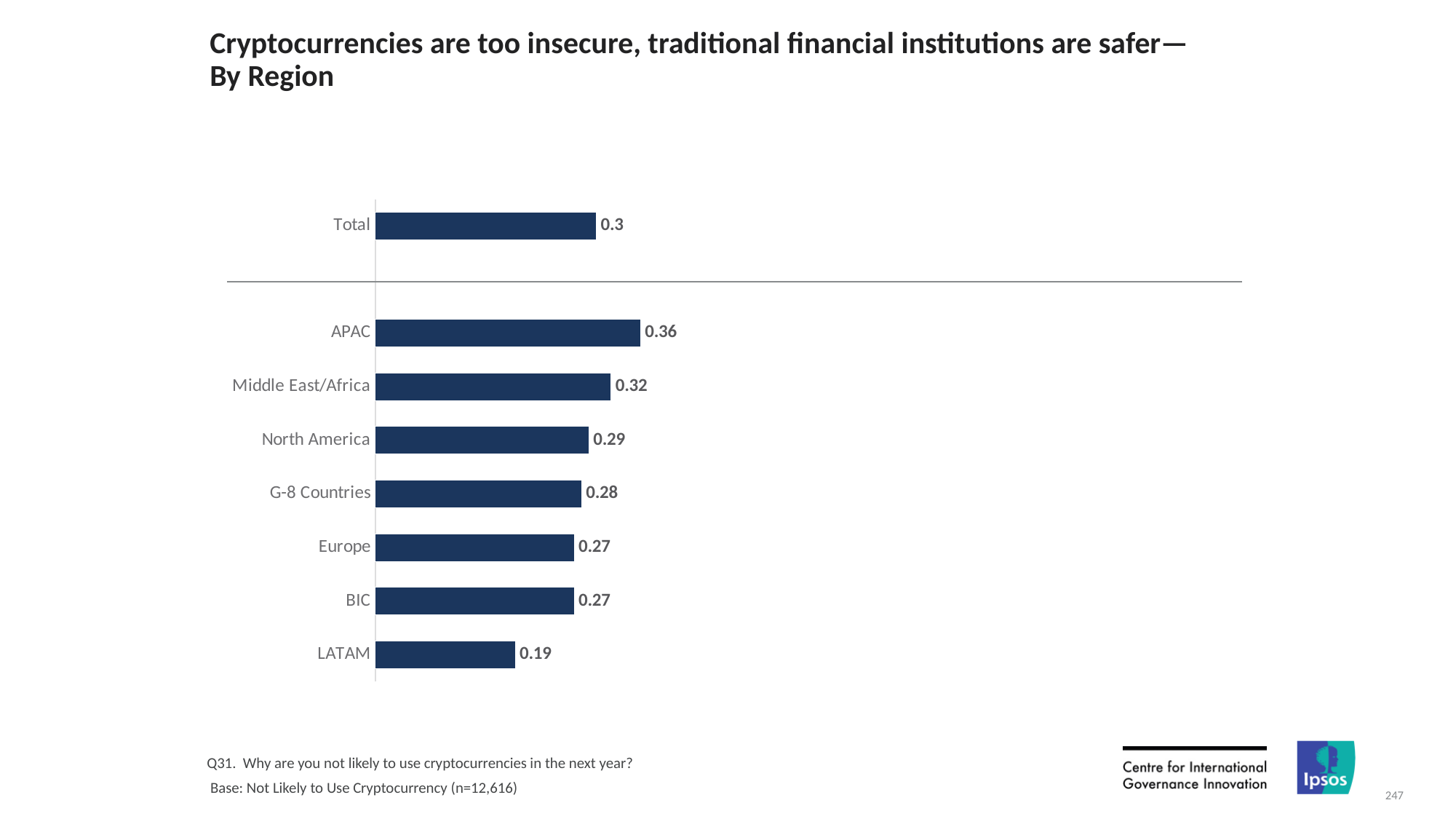
What is the difference between the values for Middle East/Africa and North America? 0.03 Which is larger, the value for North America or the value for Europe? North America What is the difference between the values for APAC and LATAM? 0.17 What is the value for Middle East/Africa? 0.32 What kind of chart is shown on the slide? Bar chart What is the value for Total? 0.3 What is the title of the chart? Cryptocurrencies are too insecure, traditional financial institutions are safer—By Region How many bars are plotted on the chart, including Total? 8 What is the value for APAC? 0.36 Which region has the highest value? APAC Which region has the lowest value? LATAM What is the value for LATAM? 0.19